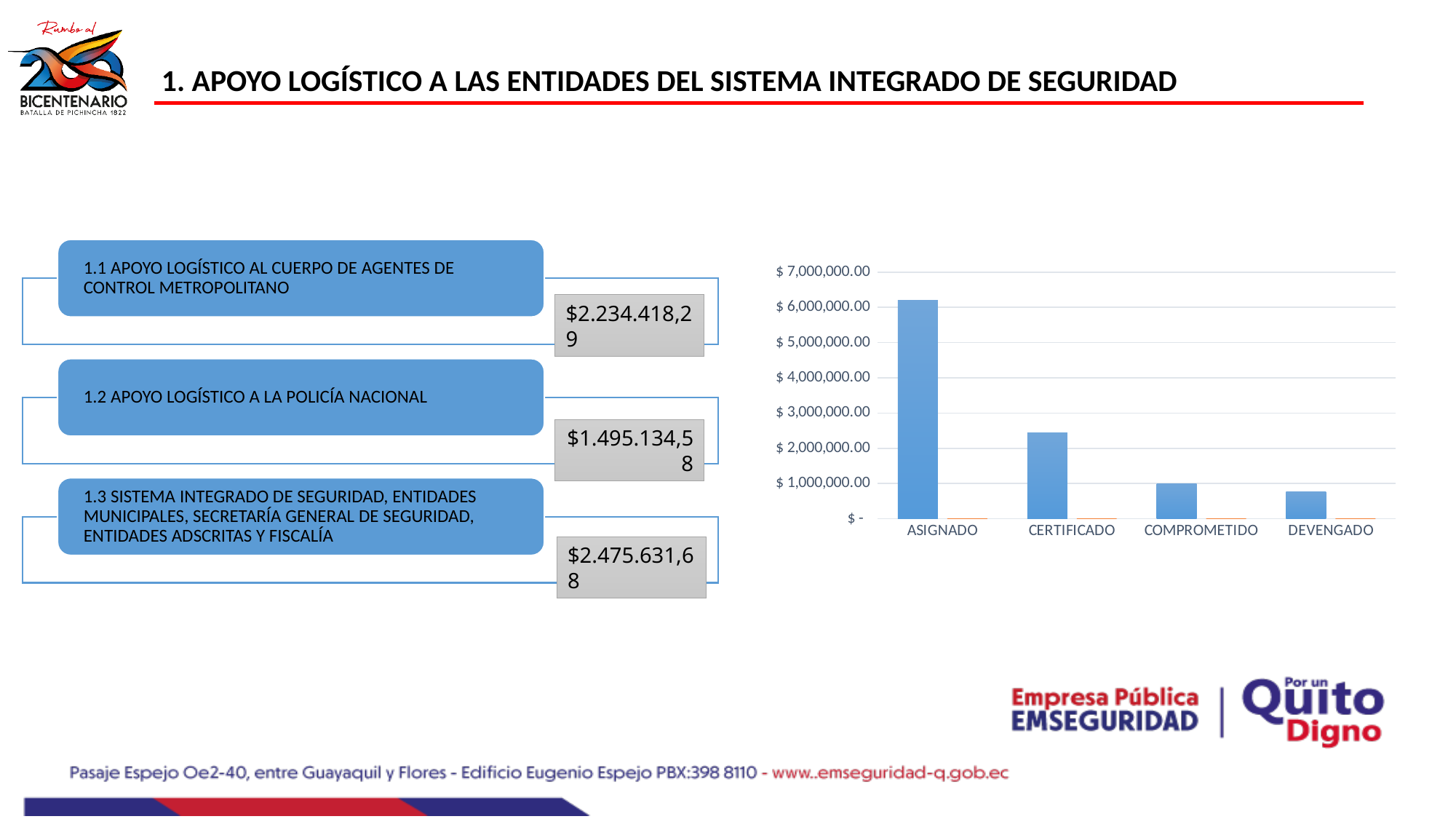
Which is larger, the value for ASIGNADO or the value for CERTIFICADO? ASIGNADO Which category has the lowest value in the chart? DEVENGADO What is the highest value shown on the chart's y axis? $ 7,000,000.00 Is the value for ASIGNADO greater or less than $5,000,000.00? greater Is the value for DEVENGADO greater or less than $1,000,000.00? less How many categories are shown on the x axis of the chart? 4 What kind of chart is shown on the slide? bar chart Is the value for CERTIFICADO greater or less than $2,000,000.00? greater Do the values rise or fall from ASIGNADO to DEVENGADO along the x axis? fall Which category has the highest value in the chart? ASIGNADO